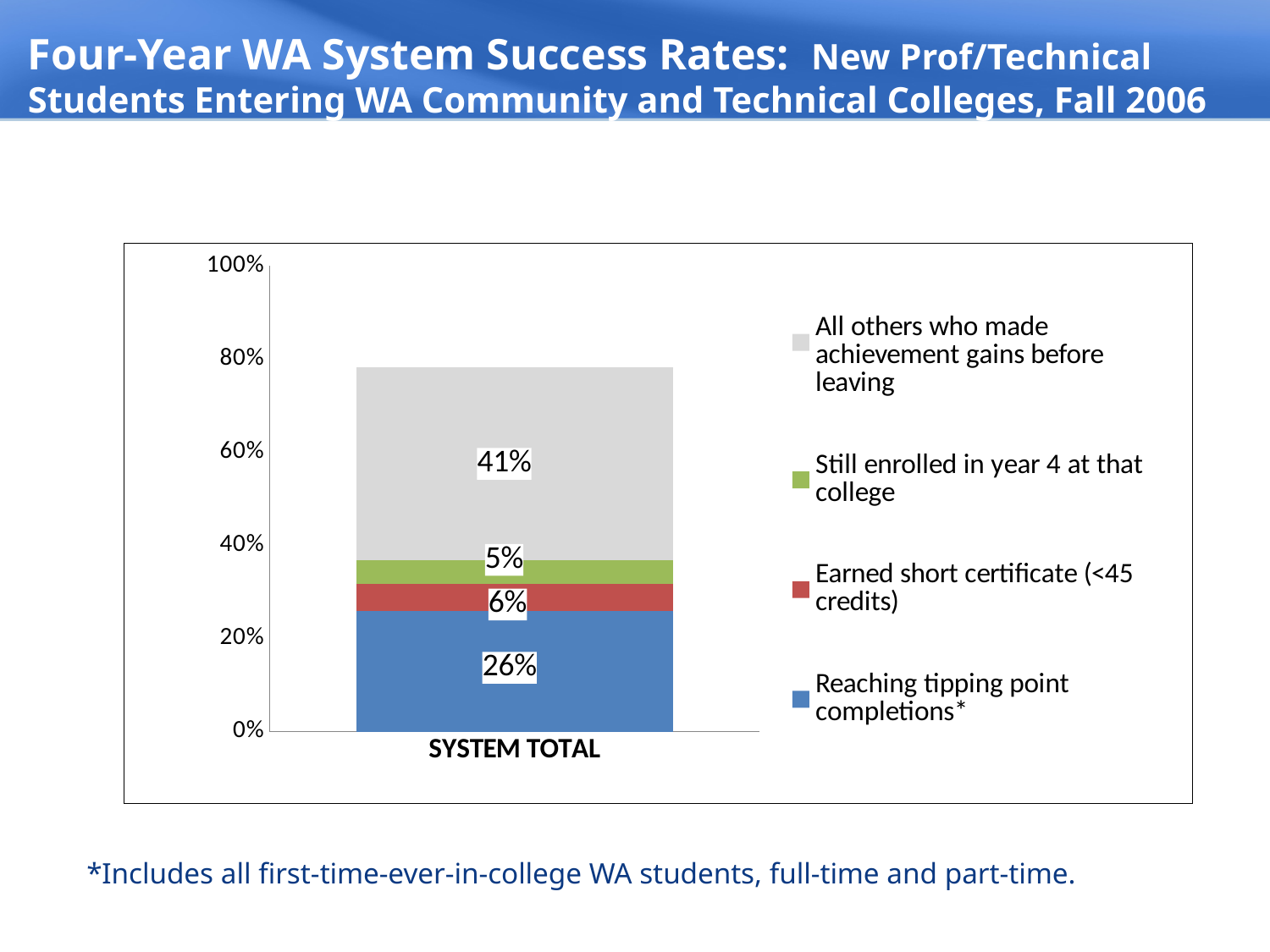
What is the label of the category on the x axis? SYSTEM TOTAL Which is larger: the share earning a short certificate or the share still enrolled in year 4? Earned short certificate (<45 credits) What is the difference between the 'All others who made achievement gains before leaving' segment and the 'Reaching tipping point completions' segment? 15% Which segment of the SYSTEM TOTAL bar has the smallest value? Still enrolled in year 4 at that college What percentage is shown for 'All others who made achievement gains before leaving'? 41% What percentage of students earned a short certificate (<45 credits)? 6% How many series does the legend list? 4 What percentage of students were still enrolled in year 4 at that college? 5% Which segment of the SYSTEM TOTAL bar has the largest value? All others who made achievement gains before leaving What kind of chart is shown on the slide? Stacked bar chart What is the total of all four segments in the SYSTEM TOTAL stacked bar? 78% What percentage of students reached tipping point completions in the SYSTEM TOTAL bar? 26%